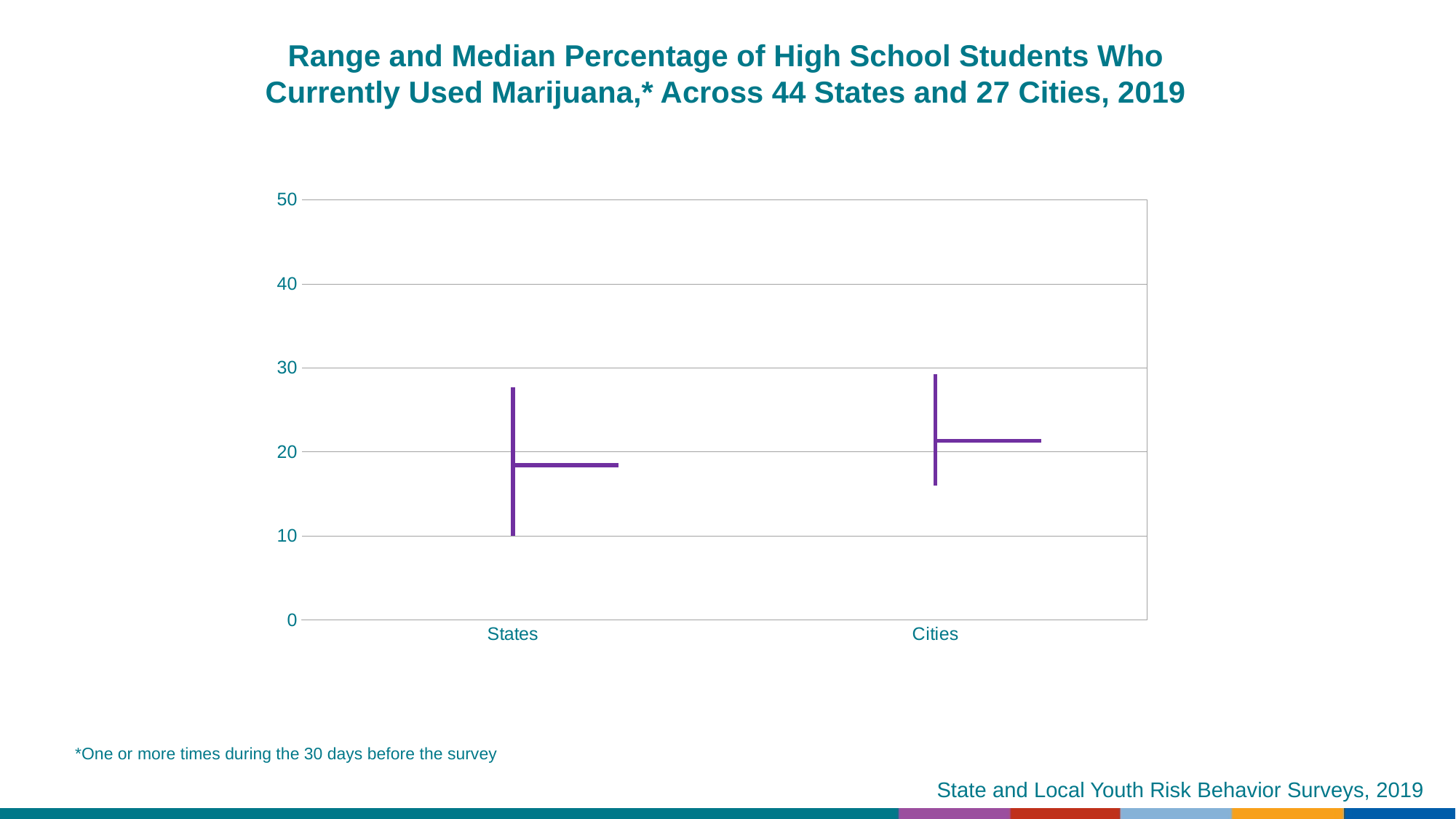
Is the median value for Cities greater or less than 20? greater What is the highest value shown on the y axis? 50 Which category has the lower bottom of its range? States Is the top of the range for States greater or less than 20? greater Which category has the higher median percentage, States or Cities? Cities Which category has the higher top of its range? Cities How many categories are shown on the x axis of the chart? 2 Is the top of the range for Cities greater or less than 30? less Does the median percentage rise or fall from States to Cities? rise According to the title, how many states and cities are included in the chart? 44 states and 27 cities